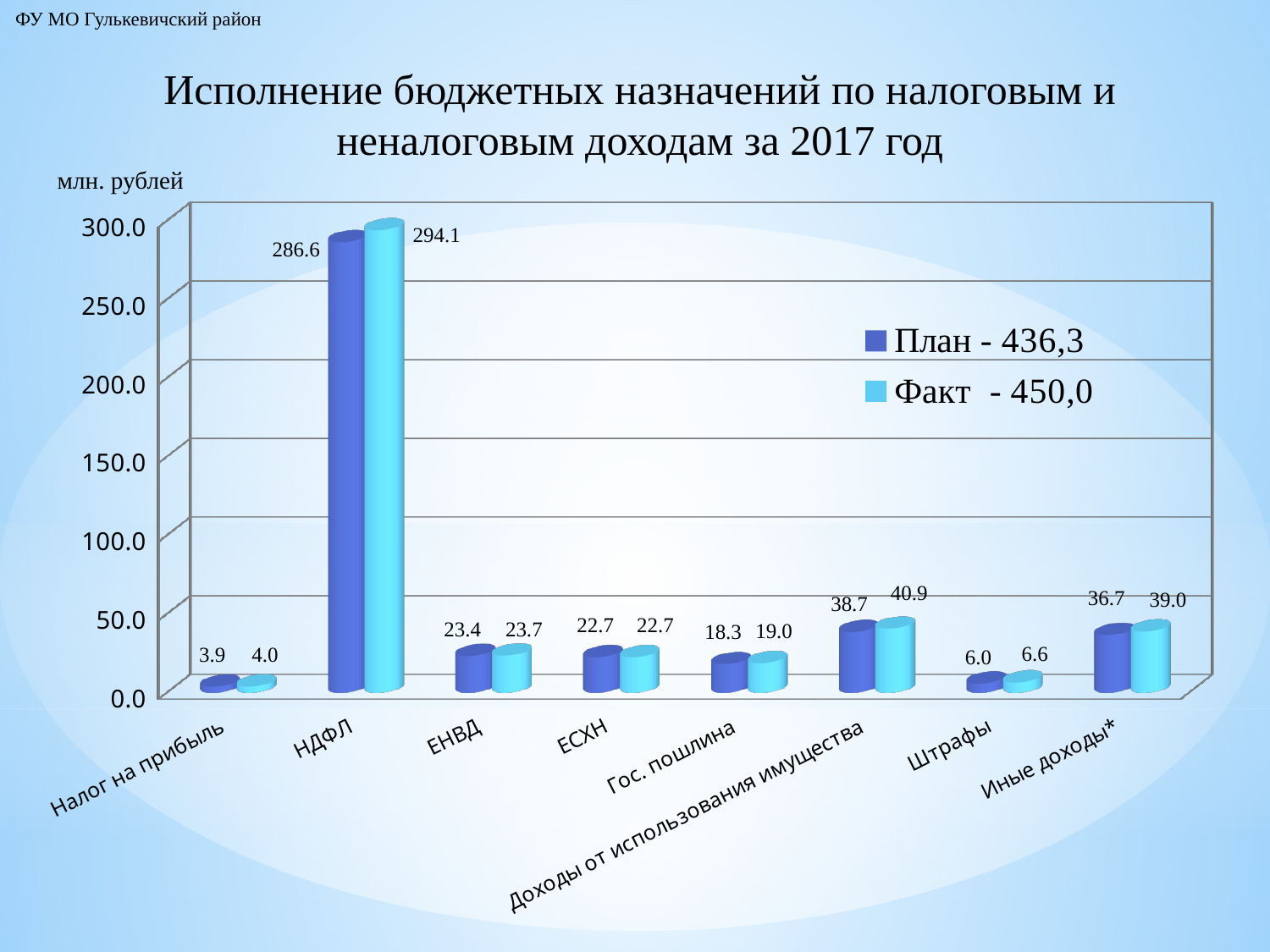
What is the План value for НДФЛ? 286.6 How many series does the legend list? 2 What is the Факт value for Доходы от использования имущества? 40.9 Is the Факт value for НДФЛ greater or less than 250.0? greater Which category has the highest Факт value? НДФЛ What kind of chart is shown on the slide? bar chart What is the План value for Гос. пошлина? 18.3 Which is larger for Иные доходы*, the План value or the Факт value? Факт How many categories are shown on the x axis? 8 What is the difference between the Факт and План values for НДФЛ? 7.5 Which category has the lowest План value? Налог на прибыль What is the Факт value for Штрафы? 6.6